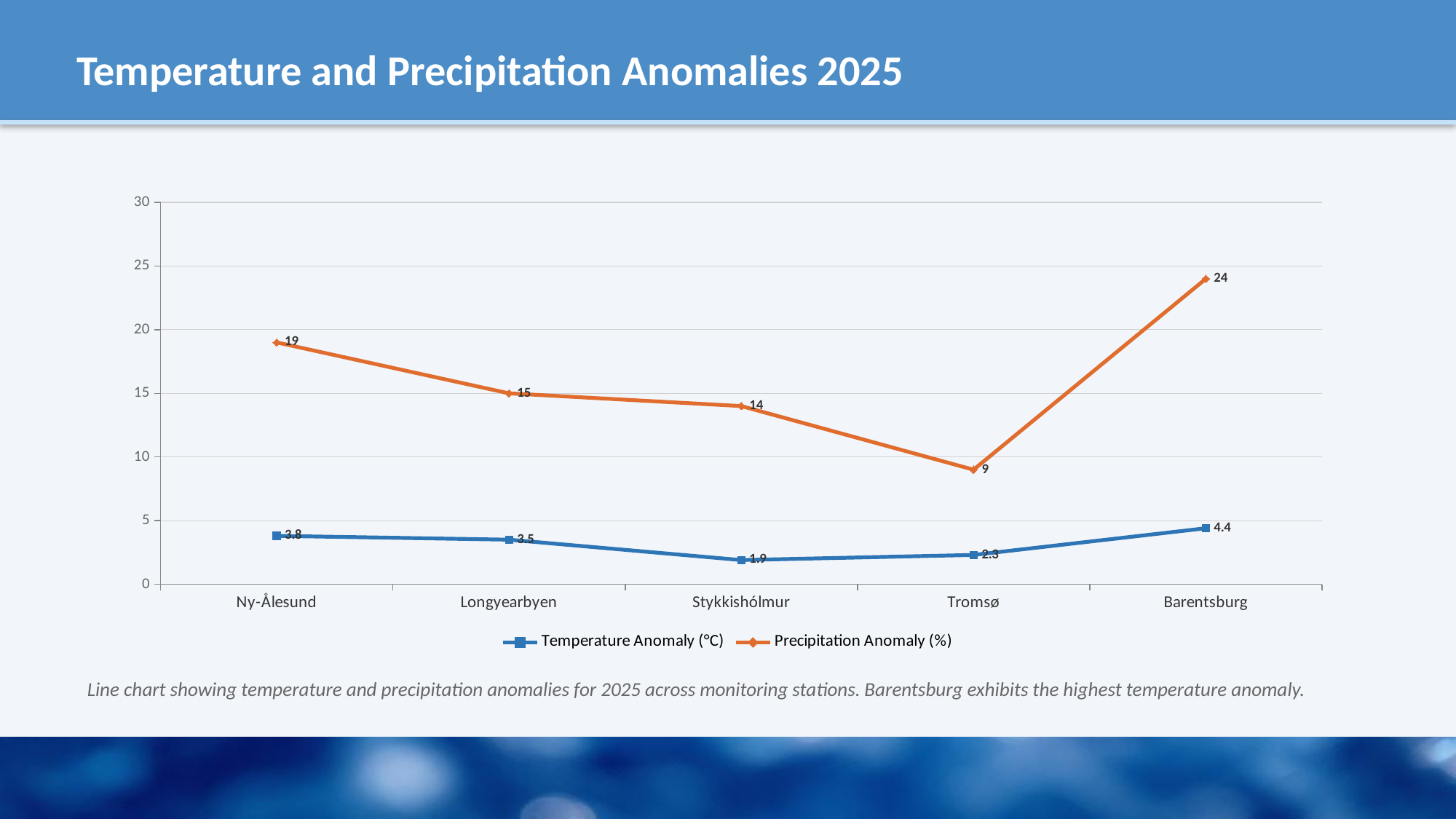
Is the Precipitation Anomaly (%) for Stykkishólmur greater or less than 10? greater Does the Precipitation Anomaly (%) rise or fall from Ny-Ålesund to Tromsø? Fall What kind of chart is shown on the slide? Line chart Which station has the highest Temperature Anomaly (°C)? Barentsburg What is the difference in Precipitation Anomaly (%) between Ny-Ålesund and Longyearbyen? 4 What is the Precipitation Anomaly (%) for Tromsø? 9 What is the Precipitation Anomaly (%) for Barentsburg? 24 How many series does the legend list? 2 What is the Temperature Anomaly (°C) for Stykkishólmur? 1.9 How many monitoring stations are shown on the x axis? 5 Which station has a larger Temperature Anomaly (°C), Ny-Ålesund or Tromsø? Ny-Ålesund Which station has the lowest Precipitation Anomaly (%)? Tromsø